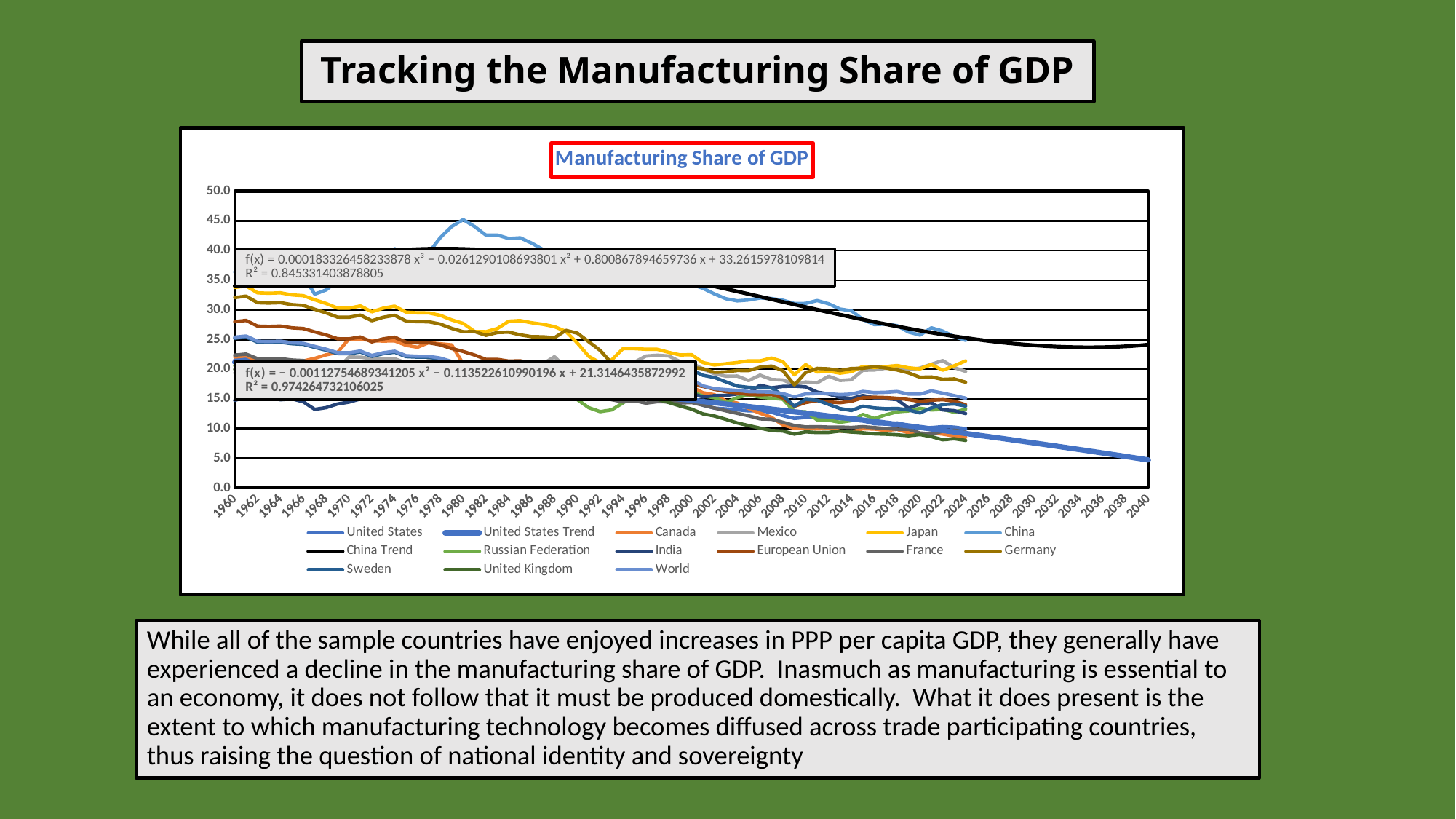
What kind of chart is shown on the slide? line chart Is the peak value of the China line around 1980 greater or less than 40.0? greater What is the last year labelled on the horizontal axis? 2040 What is the title of the chart? Manufacturing Share of GDP How many series does the chart's legend list? 15 Does the China line rise or fall between 1980 and 2024? fall In 1960, which line is higher: Japan or United States? Japan What is the highest value shown on the vertical axis? 50.0 Is the value of the Japan line in 1960 greater or less than 30.0? greater Is the value of the United States Trend line at 2040 greater or less than 10.0? less Which series reaches the highest value anywhere on the chart? China Does the United States Trend line rise or fall from 1960 to 2040? fall